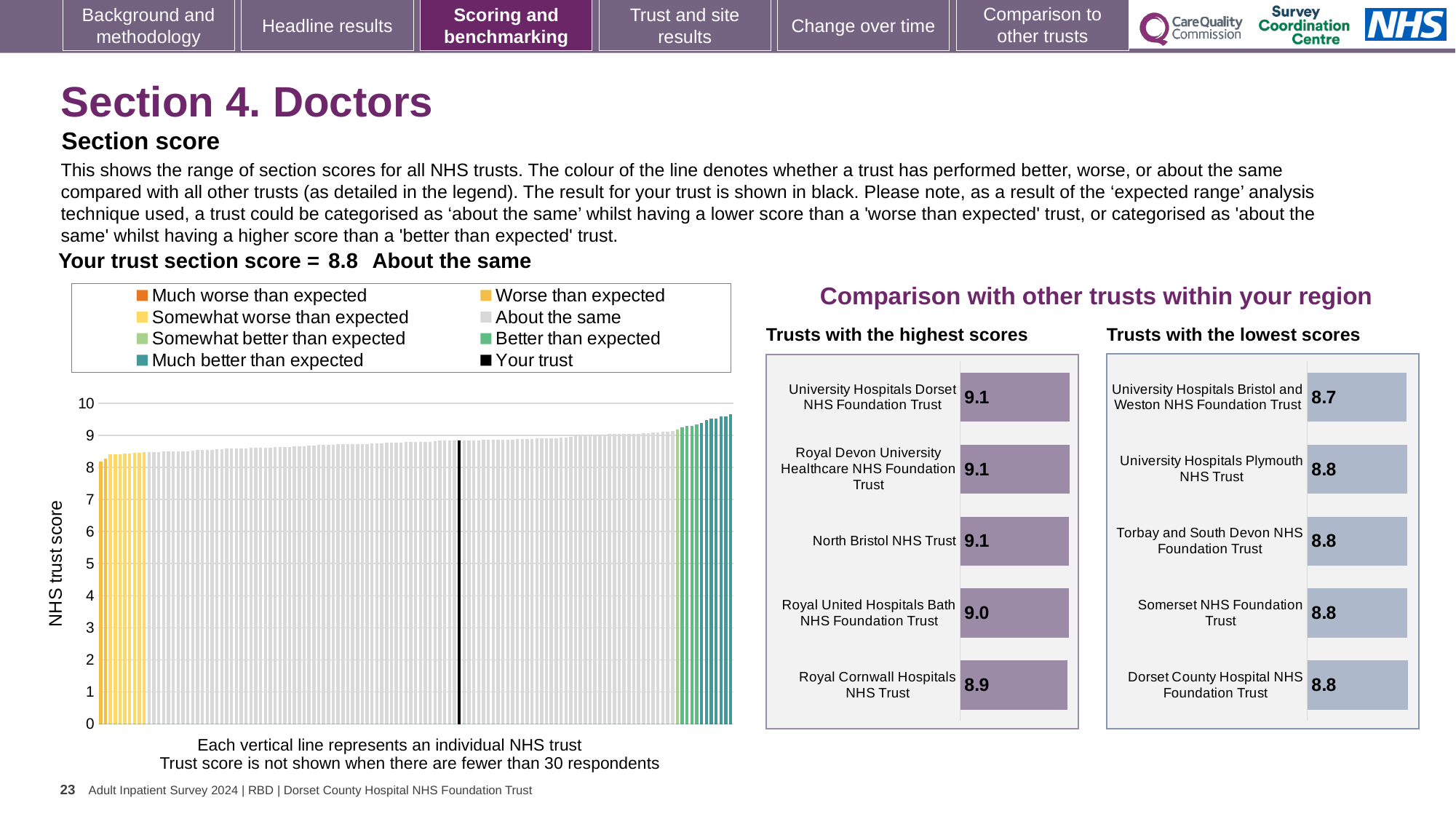
How many trusts are listed in the 'Trusts with the highest scores' chart? 5 In the 'Trusts with the lowest scores' chart, what is the difference between the score for Dorset County Hospital NHS Foundation Trust and the score for University Hospitals Bristol and Weston NHS Foundation Trust? 0.1 In the 'Trusts with the highest scores' chart, which has the larger score: Royal United Hospitals Bath NHS Foundation Trust or Royal Cornwall Hospitals NHS Trust? Royal United Hospitals Bath NHS Foundation Trust What type of chart is the large 'NHS trust score' chart on the left of the slide? Bar chart In the 'Trusts with the lowest scores' chart, what is the score for University Hospitals Bristol and Weston NHS Foundation Trust? 8.7 In the large 'NHS trust score' chart, is the lowest trust score shown greater or less than 8? greater How many entries does the legend of the large 'NHS trust score' chart list? 8 In the 'Trusts with the highest scores' chart, which trust has the lowest score? Royal Cornwall Hospitals NHS Trust According to the slide, what is your trust's section score for Section 4. Doctors? 8.8 In the 'Trusts with the highest scores' chart, what is the difference between the score for University Hospitals Dorset NHS Foundation Trust and the score for Royal Cornwall Hospitals NHS Trust? 0.2 In the 'Trusts with the lowest scores' chart, which trust has the lowest score? University Hospitals Bristol and Weston NHS Foundation Trust In the 'Trusts with the highest scores' chart, what is the score for Royal United Hospitals Bath NHS Foundation Trust? 9.0